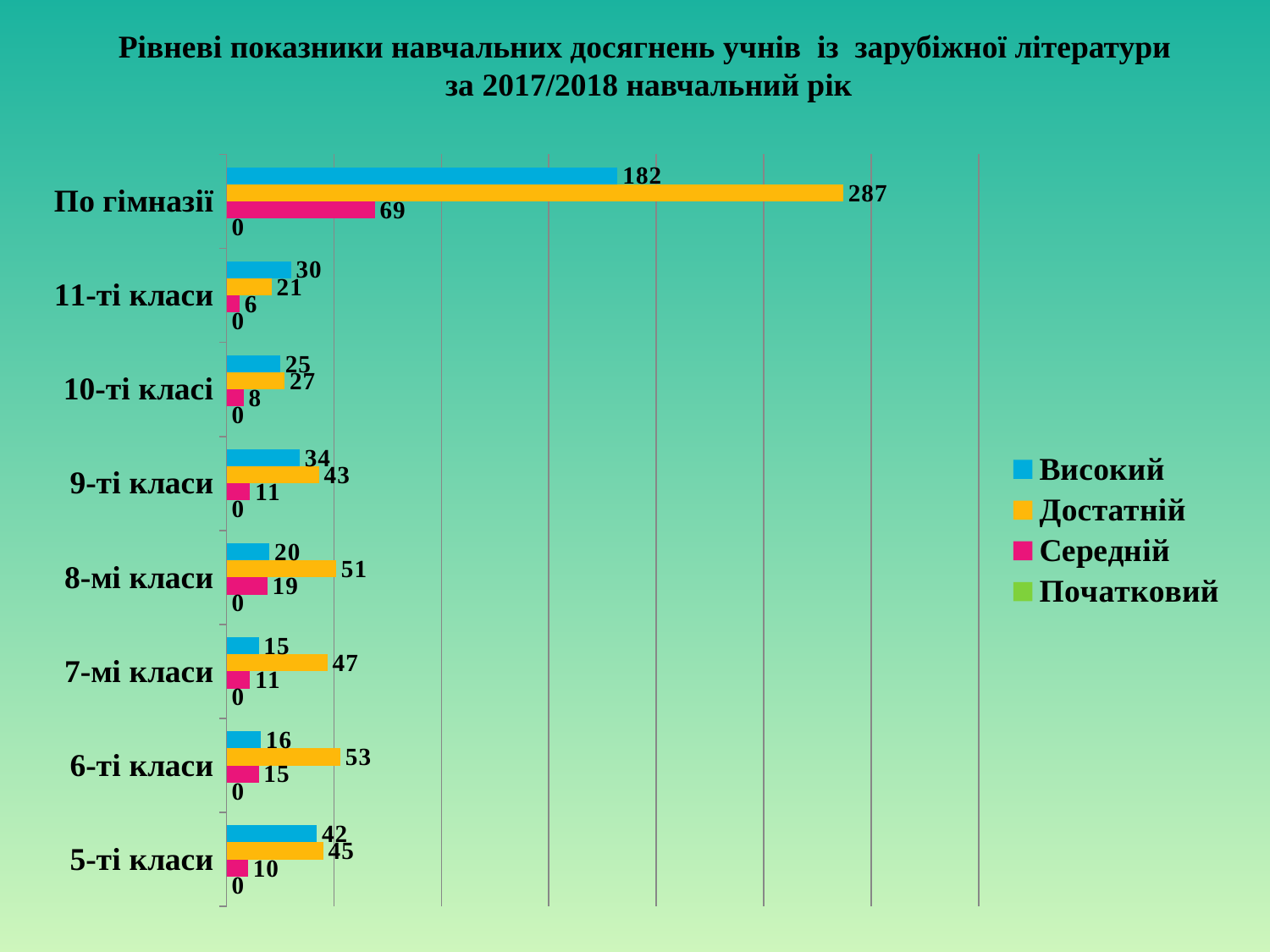
How many series does the legend list? 4 Among the class categories (excluding По гімназії), which has the highest Достатній value? 6-ті класи What is the value of Високий for 5-ті класи? 42 What is the value of Початковий for 7-мі класи? 0 What is the value of Середній for 8-мі класи? 19 What is the value of Достатній for По гімназії? 287 What type of chart is shown? bar chart What colour represents the Середній series? pink What is the difference between the Достатній and Високий values for По гімназії? 105 Which is larger for 10-ті класі: Високий or Достатній? Достатній How many categories are shown on the chart? 8 Which category has the lowest Середній value? 11-ті класи